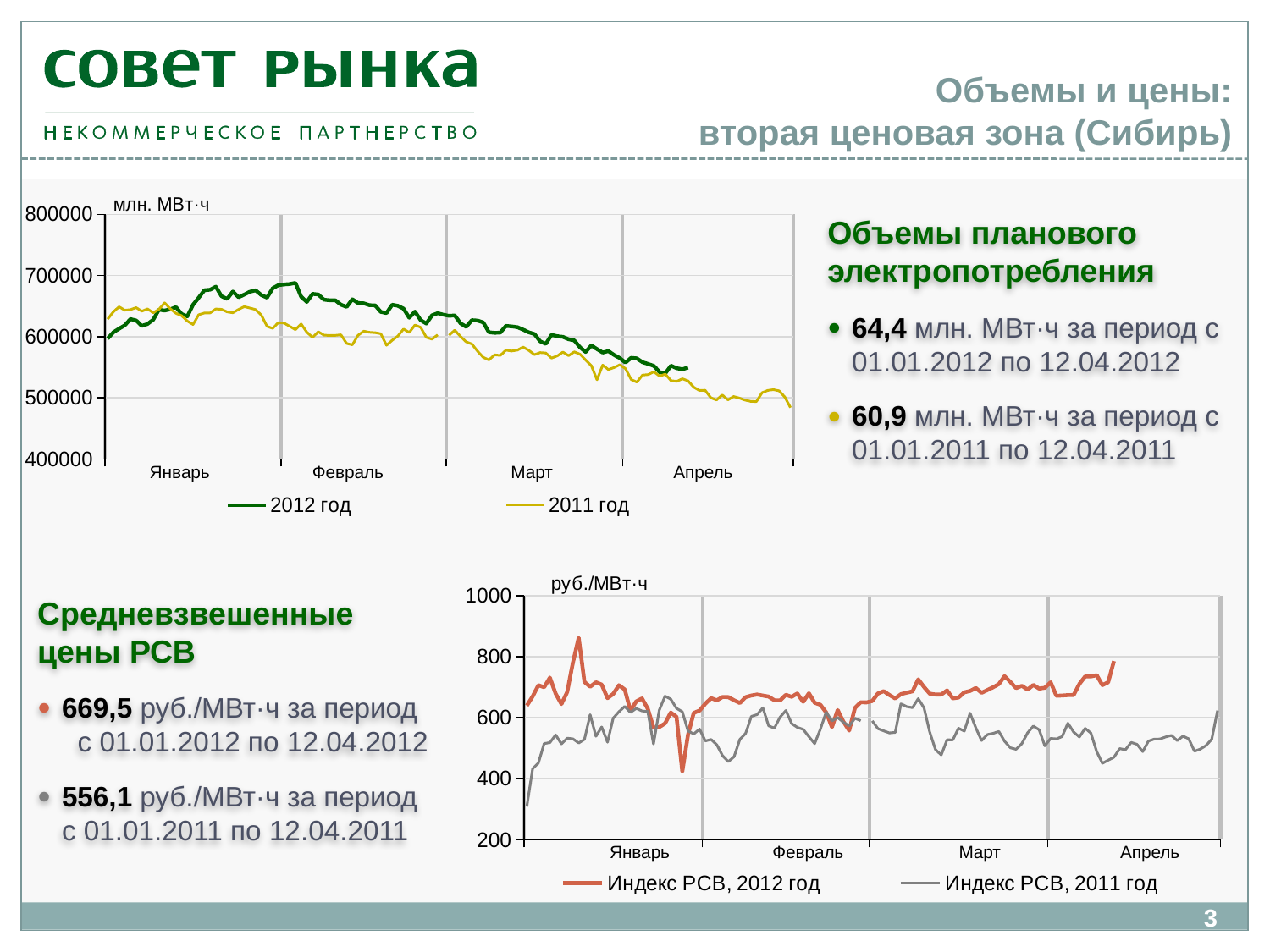
How many series does the legend of the bottom chart list? 2 How many series does the legend of the top chart list? 2 In the bottom chart, which series is higher during March, Индекс РСВ, 2012 год or Индекс РСВ, 2011 год? Индекс РСВ, 2012 год In the bottom chart, is the peak value of Индекс РСВ, 2012 год in January greater or less than 800? greater In the top chart, is the highest value of the 2012 год series greater or less than 600000? greater In the top chart, which series is higher during February, 2012 год or 2011 год? 2012 год In the top chart, do the values of the 2012 год series rise or fall from February to April? fall In the top chart, what unit is shown on the vertical axis? млн. МВт·ч In the bottom chart, what are the two legend entries? Индекс РСВ, 2012 год; Индекс РСВ, 2011 год In the top chart, is the value of the 2011 год series at the start of January greater or less than 600000? greater What kind of chart is the bottom chart on the slide (руб./МВт·ч)? line chart What kind of chart is the top chart on the slide (млн. МВт·ч)? line chart